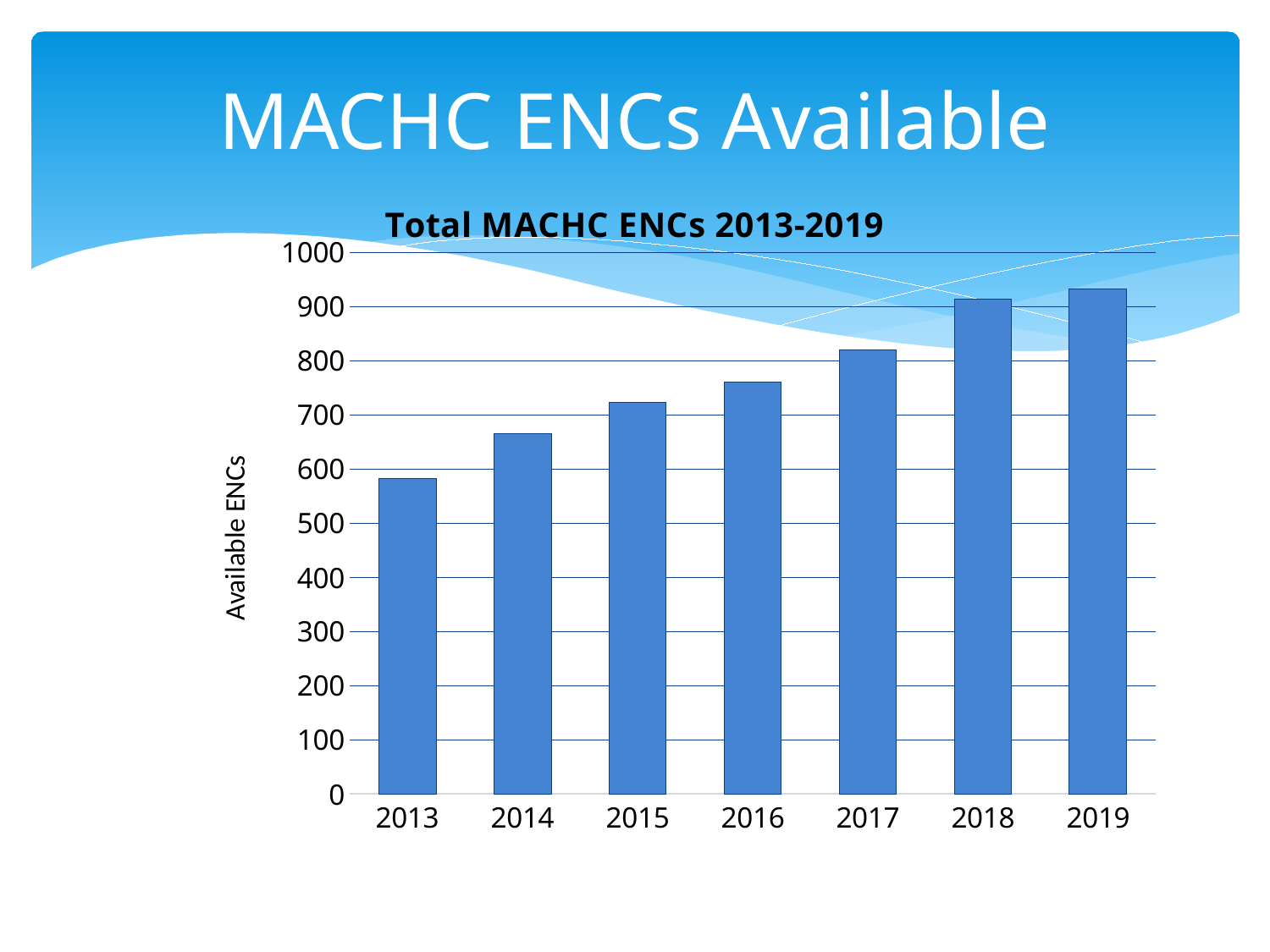
Do the values rise or fall from 2013 to 2019? rise What is the label on the vertical axis of the chart? Available ENCs Is the value for 2017 greater or less than 800? greater Which year has the lowest number of available ENCs? 2013 Is the value for 2014 greater or less than 600? greater Which is larger, the value for 2015 or the value for 2017? 2017 What kind of chart is shown on the slide? bar chart Is the value for 2016 greater or less than 800? less How many years are shown on the x axis of the chart? 7 What is the title of the chart? Total MACHC ENCs 2013-2019 Which year has the highest number of available ENCs? 2019